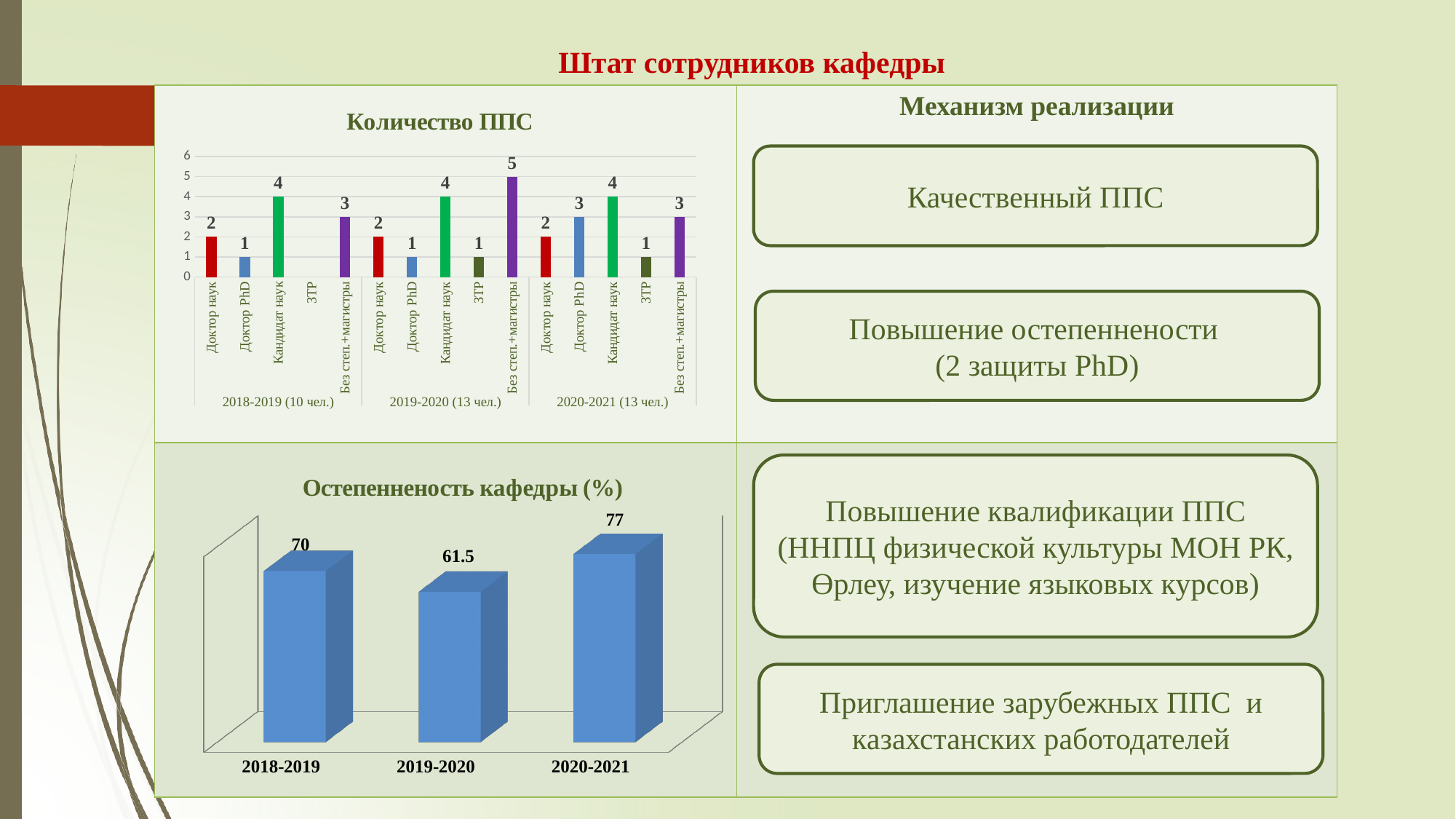
In the 'Остепенненость кафедры (%)' chart, which year has the lowest value? 2019-2020 In the 'Количество ППС' chart, what is the value for Без степ.+магистры in 2019-2020 (13 чел.)? 5 In the 'Количество ППС' chart, how many year groups are shown on the x axis? 3 In the 'Остепенненость кафедры (%)' chart, what is the difference between 2020-2021 and 2018-2019? 7 What type of chart is 'Остепенненость кафедры (%)'? bar chart In the 'Количество ППС' chart, which category has the highest value in the 2019-2020 (13 чел.) group? Без степ.+магистры In the 'Количество ППС' chart, what is the value for Кандидат наук in 2018-2019 (10 чел.)? 4 In the 'Остепенненость кафедры (%)' chart, what is the value for 2019-2020? 61.5 In the 'Количество ППС' chart, what is the value for Доктор PhD in 2020-2021 (13 чел.)? 3 In the 'Остепенненость кафедры (%)' chart, which year has the highest value? 2020-2021 In the 'Количество ППС' chart, what is the difference between Кандидат наук and Доктор наук in 2020-2021 (13 чел.)? 2 In the 'Количество ППС' chart, which is larger: Доктор PhD in 2019-2020 (13 чел.) or Доктор PhD in 2020-2021 (13 чел.)? Доктор PhD in 2020-2021 (13 чел.)